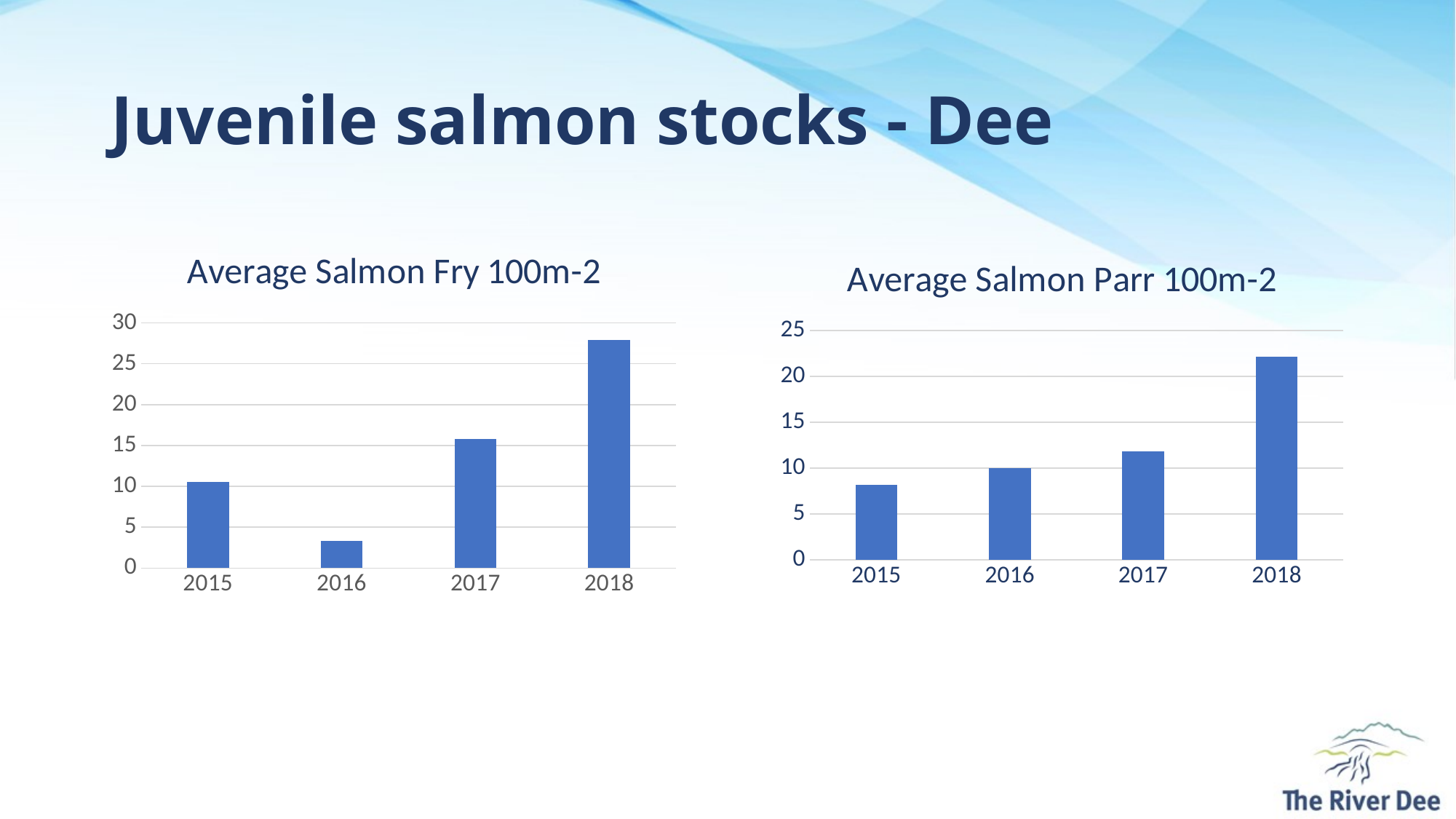
In the 'Average Salmon Fry 100m-2' chart, which is larger, the value for 2015 or the value for 2017? 2017 In the 'Average Salmon Fry 100m-2' chart, is the value for 2018 greater or less than 25? greater What kind of chart is the 'Average Salmon Fry 100m-2' chart? bar chart In the 'Average Salmon Fry 100m-2' chart, is the value for 2016 greater or less than 5? less In the 'Average Salmon Parr 100m-2' chart, do the values rise or fall from 2015 to 2018? rise How many years are shown on the x axis of the 'Average Salmon Parr 100m-2' chart? 4 In the 'Average Salmon Fry 100m-2' chart, which year has the highest value? 2018 In the 'Average Salmon Fry 100m-2' chart, which year has the lowest value? 2016 In the 'Average Salmon Parr 100m-2' chart, which year has the lowest value? 2015 In the 'Average Salmon Parr 100m-2' chart, which year has the highest value? 2018 In the 'Average Salmon Parr 100m-2' chart, is the value for 2015 greater or less than 10? less